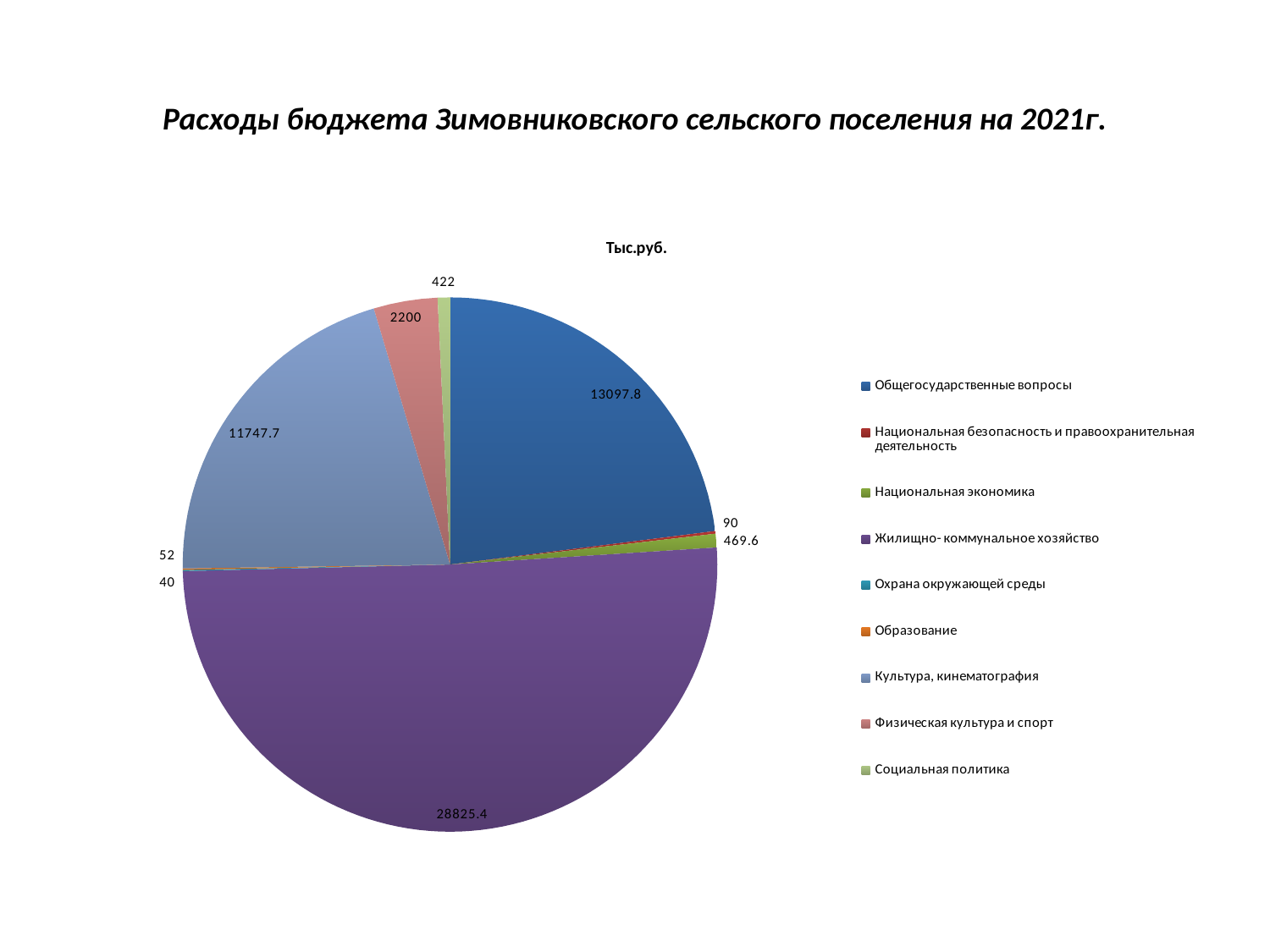
What is the title shown above the pie chart? Тыс.руб. Which is larger: Общегосударственные вопросы or Культура, кинематография? Общегосударственные вопросы What is the value for Физическая культура и спорт? 2200 What is the value for Общегосударственные вопросы? 13097.8 What is the value for Жилищно- коммунальное хозяйство? 28825.4 How many categories does the legend list? 9 Which category has the largest slice of the pie? Жилищно- коммунальное хозяйство What is the difference between the values for Жилищно- коммунальное хозяйство and Общегосударственные вопросы? 15727.6 What type of chart is shown on the slide? pie chart What is the value for Социальная политика? 422 What is the value for Культура, кинематография? 11747.7 Which category has the smallest value? Охрана окружающей среды